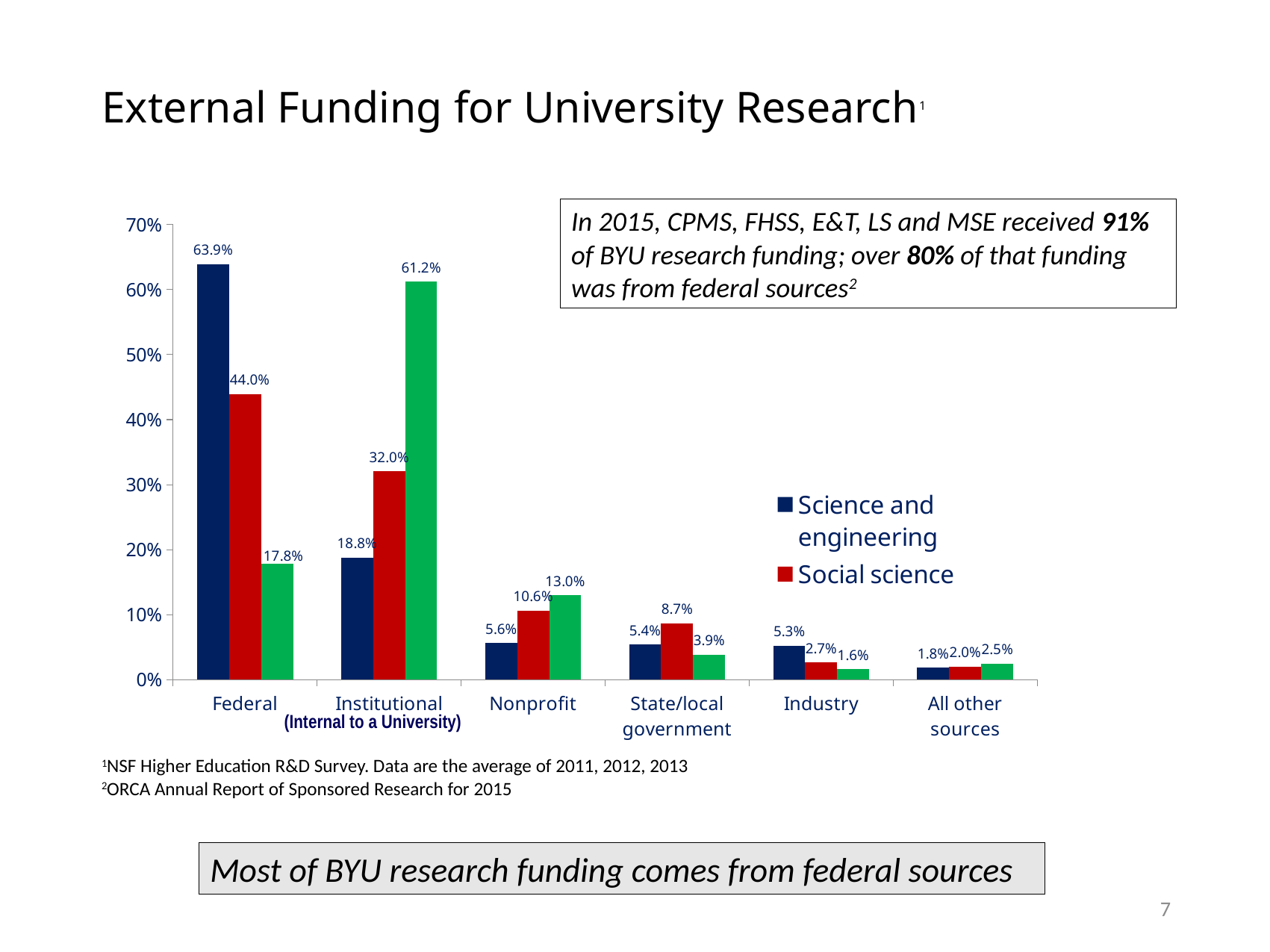
What is the Science and engineering value for Industry? 5.3% Which is larger for Nonprofit: the Science and engineering value or the Social science value? Social science What colour are the Social science bars? red What is the difference between the Science and engineering and Social science values for Federal? 19.9% What is the Social science value for State/local government? 8.7% How many categories are shown on the x axis? 6 Which category has the lowest Social science value? All other sources What kind of chart is shown on the slide? bar chart Is the Social science value for Federal greater or less than 40%? greater What is the Science and engineering value for Federal? 63.9% What is the Social science value for Institutional? 32.0% Which category has the highest Science and engineering value? Federal